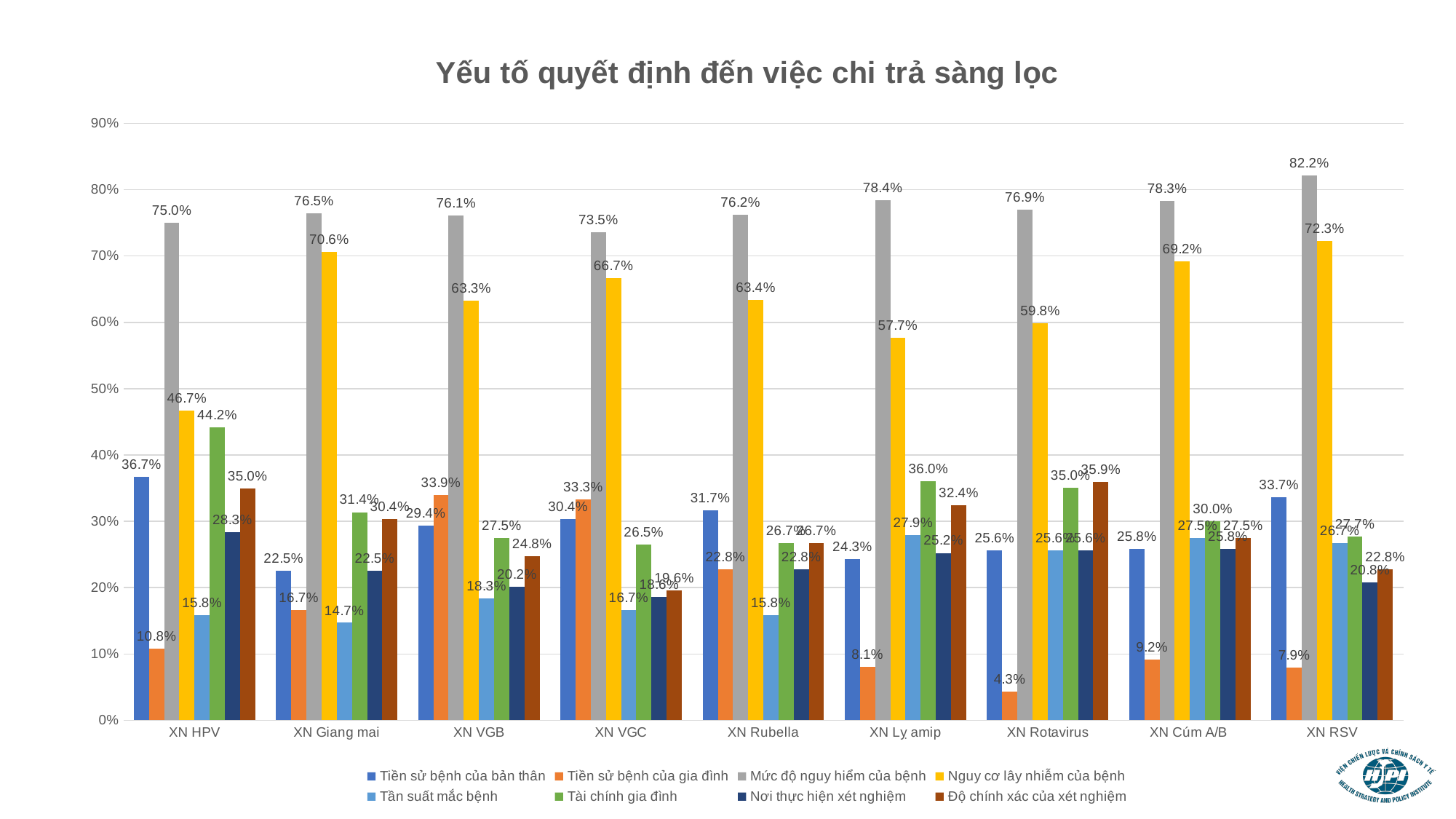
Which category has the lowest value for Tiền sử bệnh của gia đình? XN Rotavirus What type of chart is shown on the slide? Bar chart Which category has the highest value for Mức độ nguy hiểm của bệnh? XN RSV What is the value of Tiền sử bệnh của gia đình for XN Rotavirus? 4.3% What is the difference between the Nguy cơ lây nhiễm của bệnh values for XN RSV and XN HPV? 25.6 percentage points What is the value of Mức độ nguy hiểm của bệnh for XN RSV? 82.2% Which has a larger Tài chính gia đình value, XN HPV or XN Giang mai? XN HPV How many categories are shown on the x axis? 9 Which category has the highest value for Nguy cơ lây nhiễm của bệnh? XN RSV How many series does the legend list? 8 What is the difference between the Mức độ nguy hiểm của bệnh values for XN RSV and XN VGC? 8.7 percentage points What is the value of Tần suất mắc bệnh for XN Lỵ amip? 27.9%